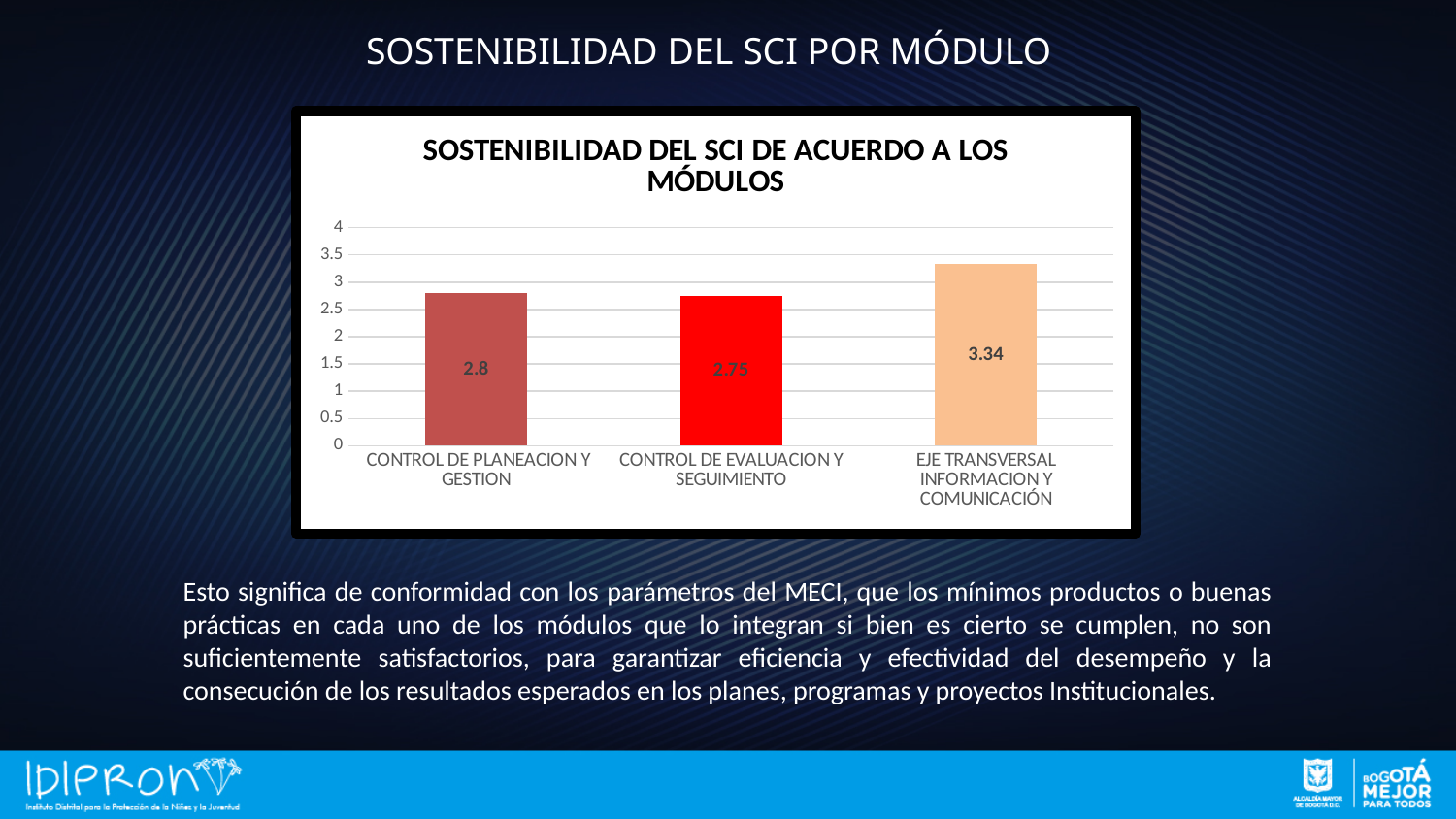
What is the value for CONTROL DE EVALUACION Y SEGUIMIENTO? 2.75 What is the difference between the values for CONTROL DE PLANEACION Y GESTION and CONTROL DE EVALUACION Y SEGUIMIENTO? 0.05 What is the title of the chart? SOSTENIBILIDAD DEL SCI DE ACUERDO A LOS MÓDULOS How many modules are shown in the chart? 3 Which module has the lowest value? CONTROL DE EVALUACION Y SEGUIMIENTO Which module has the highest value? EJE TRANSVERSAL INFORMACION Y COMUNICACIÓN What kind of chart is shown on the slide? Bar chart Which is larger, the value for CONTROL DE PLANEACION Y GESTION or the value for EJE TRANSVERSAL INFORMACION Y COMUNICACIÓN? EJE TRANSVERSAL INFORMACION Y COMUNICACIÓN What is the difference between the values for EJE TRANSVERSAL INFORMACION Y COMUNICACIÓN and CONTROL DE PLANEACION Y GESTION? 0.54 What is the value for CONTROL DE PLANEACION Y GESTION? 2.8 What is the value for EJE TRANSVERSAL INFORMACION Y COMUNICACIÓN? 3.34 Is the value for EJE TRANSVERSAL INFORMACION Y COMUNICACIÓN greater or less than 3? greater